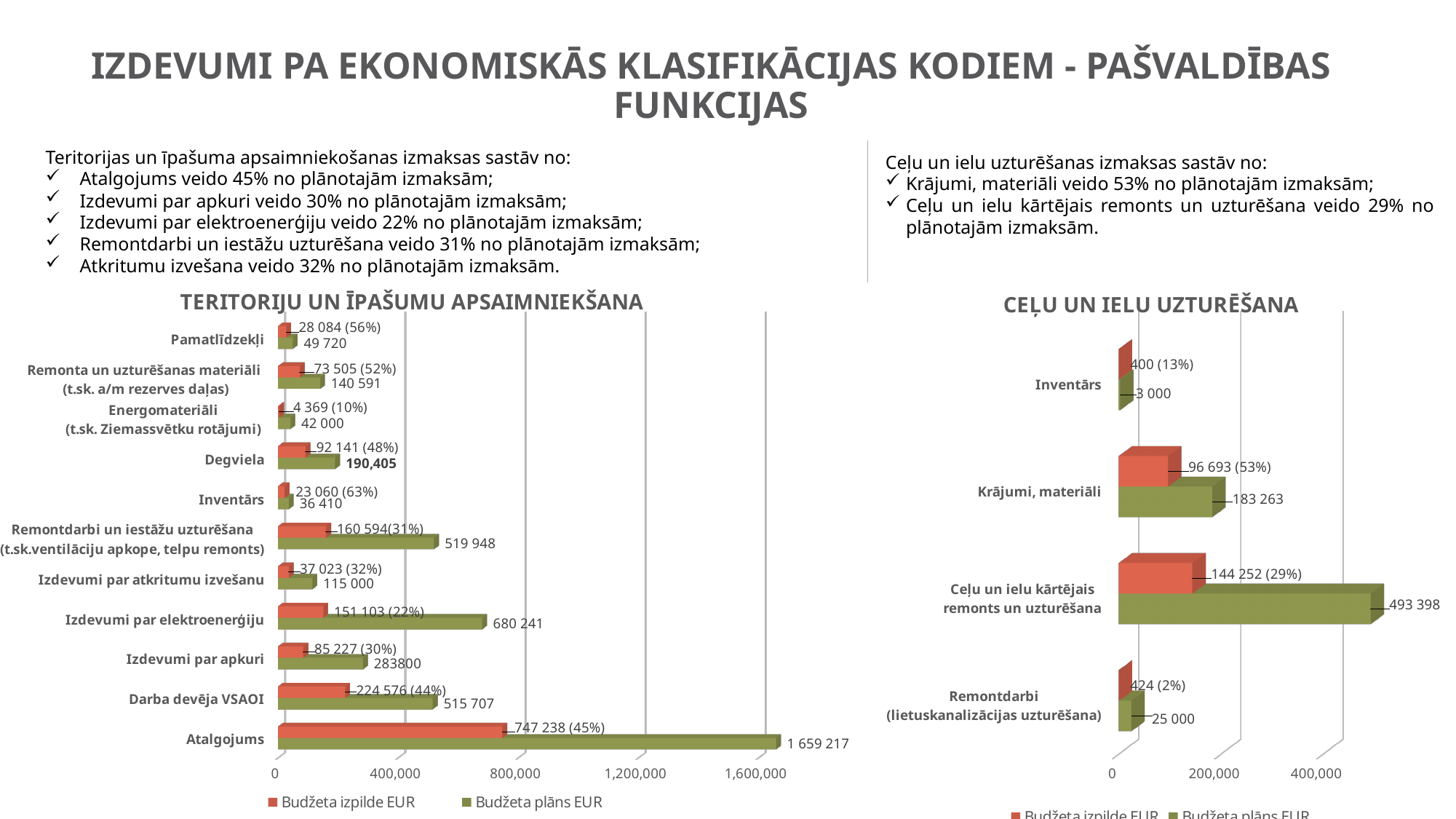
In the chart titled "CEĻU UN IELU UZTURĒŠANA", how many categories are shown? 4 In the chart titled "TERITORIJU UN ĪPAŠUMU APSAIMNIEKŠANA", what is the Budžeta izpilde EUR data label for Izdevumi par apkuri? 85 227 (30%) In the chart titled "TERITORIJU UN ĪPAŠUMU APSAIMNIEKŠANA", what is the Budžeta plāns EUR value for Atalgojums? 1 659 217 In the chart titled "TERITORIJU UN ĪPAŠUMU APSAIMNIEKŠANA", how many categories are shown on the vertical axis? 11 In the chart titled "TERITORIJU UN ĪPAŠUMU APSAIMNIEKŠANA", what is the difference between the Budžeta plāns EUR and Budžeta izpilde EUR values for Izdevumi par atkritumu izvešanu? 77 977 In the chart titled "TERITORIJU UN ĪPAŠUMU APSAIMNIEKŠANA", which is larger: the Budžeta plāns EUR value for Darba devēja VSAOI or for Izdevumi par elektroenerģiju? Izdevumi par elektroenerģiju In the chart titled "CEĻU UN IELU UZTURĒŠANA", what is the Budžeta plāns EUR value for Ceļu un ielu kārtējais remonts un uzturēšana? 493 398 In the chart titled "TERITORIJU UN ĪPAŠUMU APSAIMNIEKŠANA", which category has the lowest Budžeta izpilde EUR value? Energomateriāli (t.sk. Ziemassvētku rotājumi) In the chart titled "CEĻU UN IELU UZTURĒŠANA", what is the Budžeta izpilde EUR data label for Krājumi, materiāli? 96 693 (53%) In the chart titled "CEĻU UN IELU UZTURĒŠANA", is the Budžeta plāns EUR value for Ceļu un ielu kārtējais remonts un uzturēšana greater or less than 400,000? greater What type of chart is the chart titled "CEĻU UN IELU UZTURĒŠANA"? Bar chart In the chart titled "TERITORIJU UN ĪPAŠUMU APSAIMNIEKŠANA", which category has the highest Budžeta plāns EUR value? Atalgojums